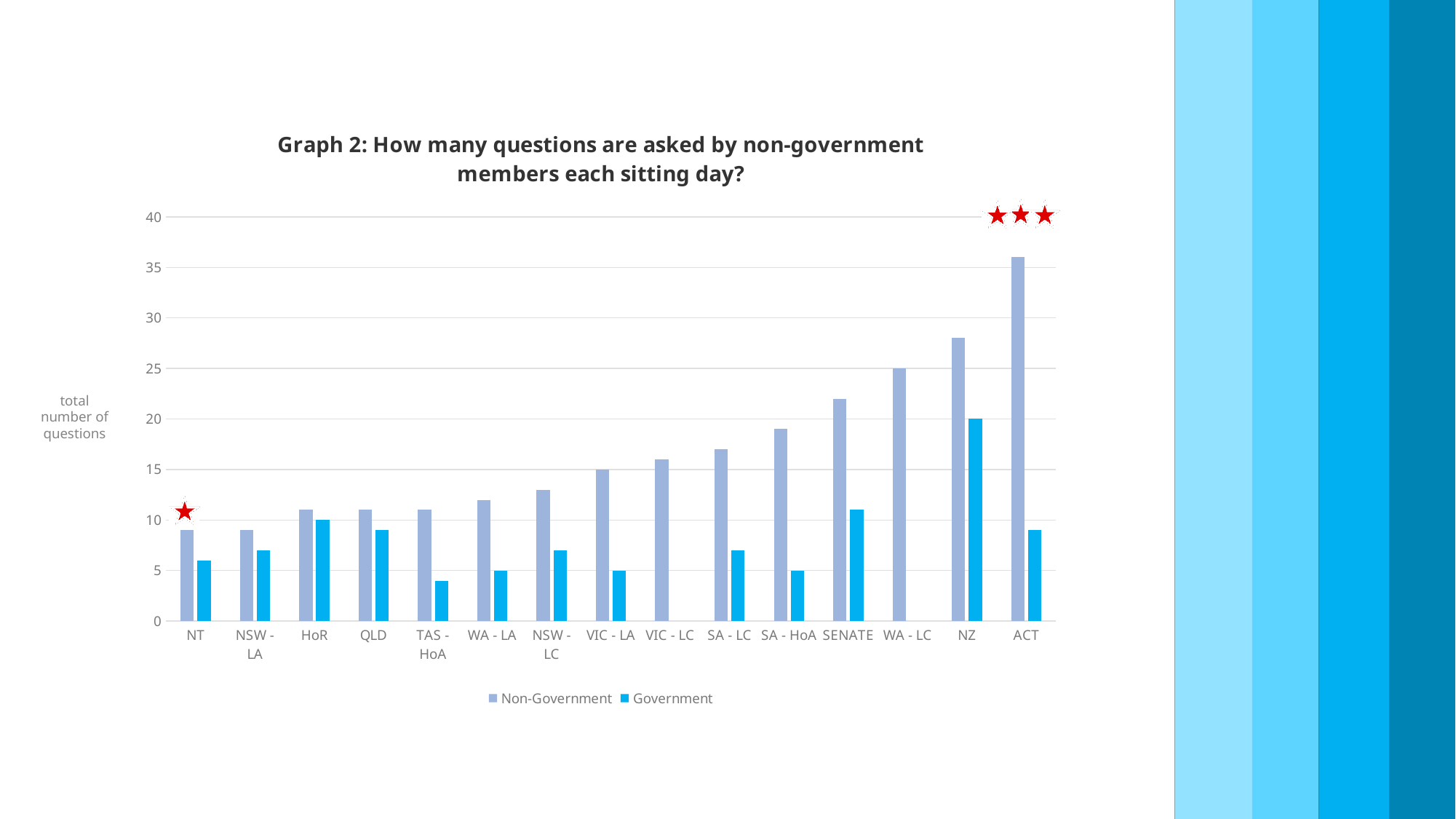
What is the Government value for NZ? 20 What is the Government value for HoR? 10 Which category has the highest Government value? NZ Which is larger, the Government value for NZ or the Government value for ACT? NZ What kind of chart is shown on the slide? bar chart Is the Non-Government value for NT greater or less than 10? less How many series does the legend list? 2 Do the Non-Government values generally rise or fall from left to right along the x axis? rise What is the Non-Government value for WA - LC? 25 Is the Non-Government value for ACT greater or less than 35? greater Which category has the highest Non-Government value? ACT How many categories are shown on the x axis? 15